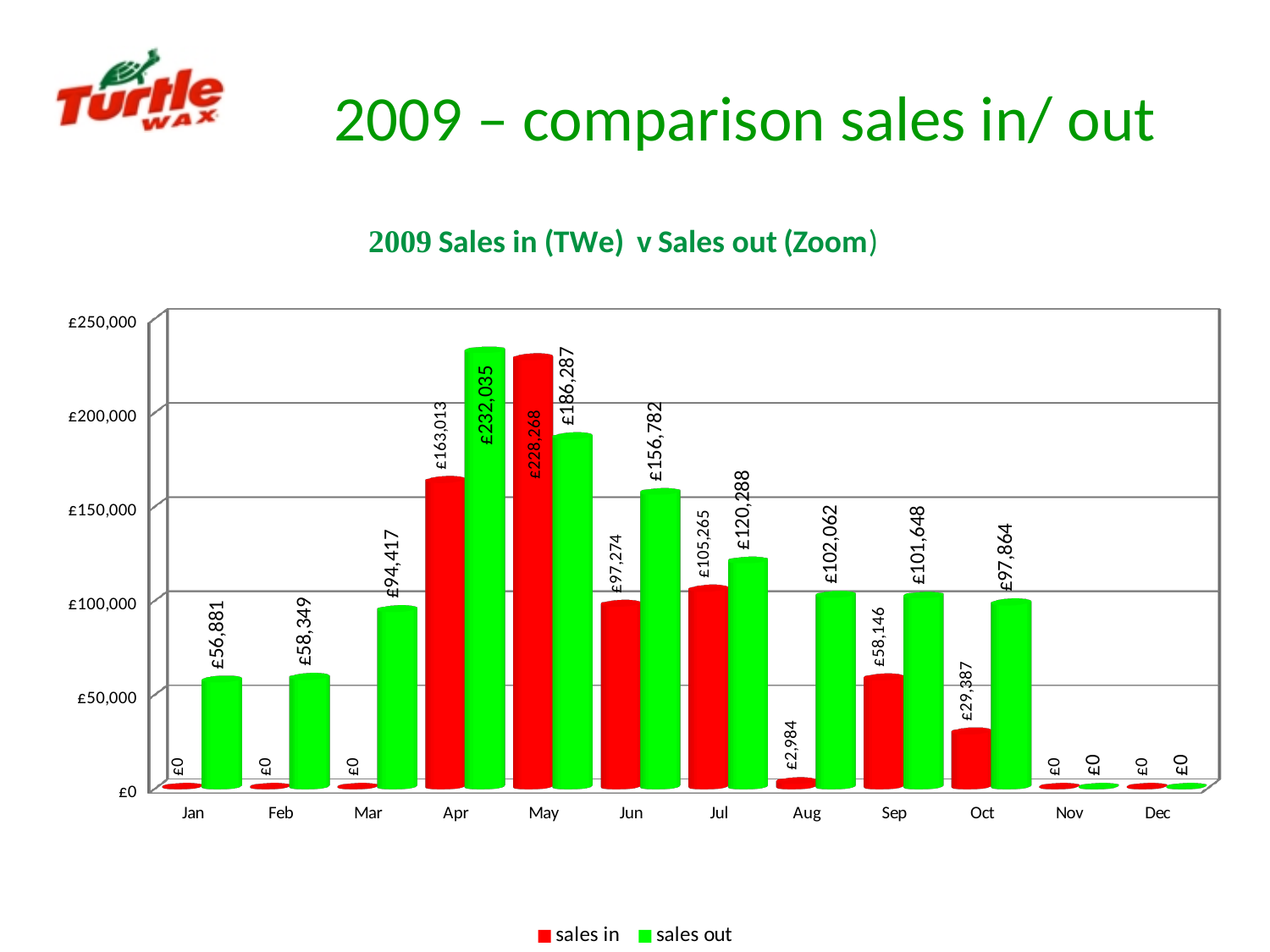
What is the value of sales in for Aug? £2,984 What is the value of sales out for Apr? £232,035 In May, which is larger: sales in or sales out? sales in What is the difference between sales out and sales in for Apr? £69,022 What kind of chart is shown on the slide? bar chart Which month has the highest sales in value? May What is the difference between sales out and sales in for Jul? £15,023 How many months are shown on the x axis? 12 Which month has the highest sales out value? Apr What is the value of sales in for Oct? £29,387 What is the value of sales in for May? £228,268 How many series does the legend list? 2